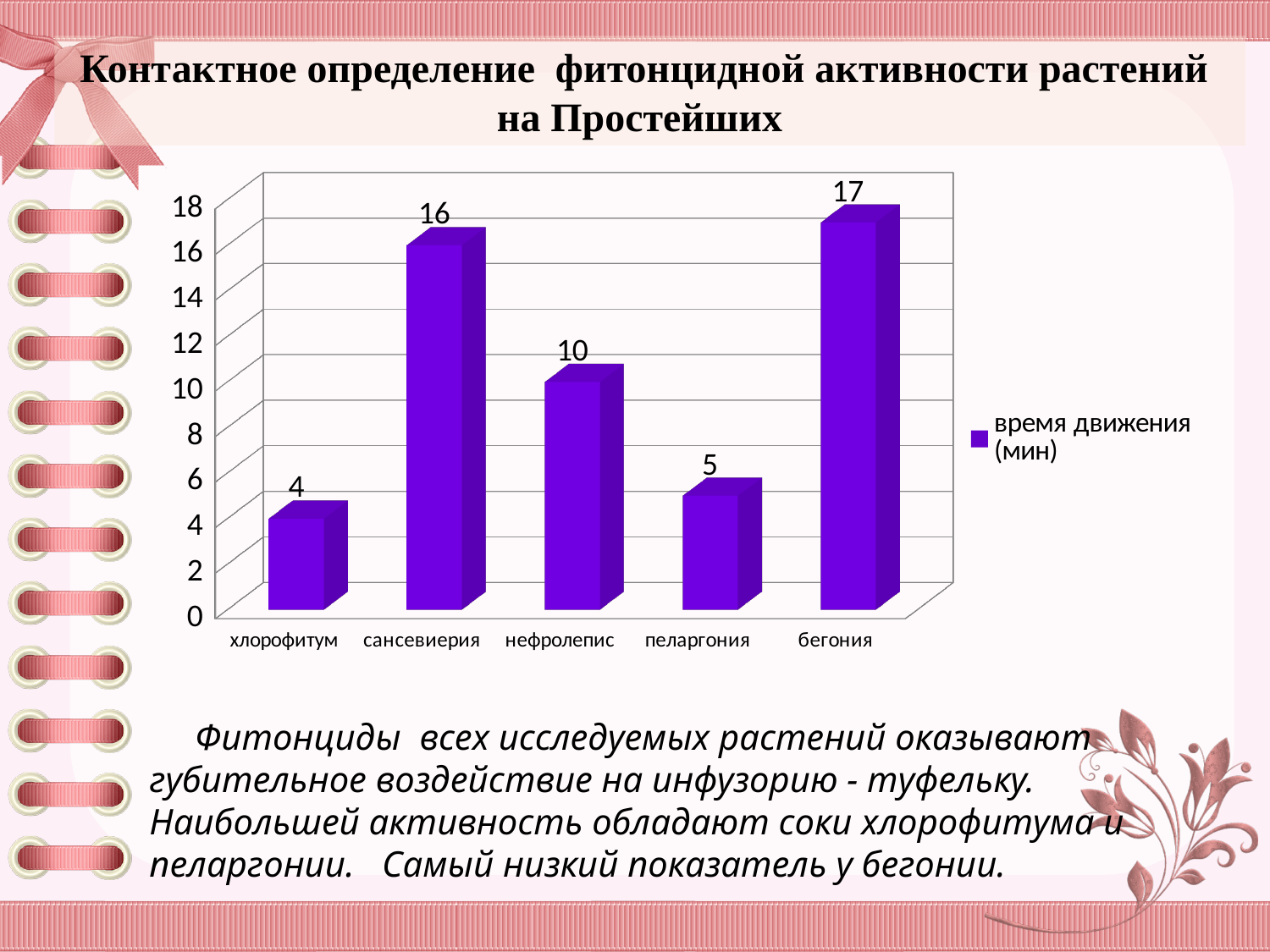
What is the value for пеларгония? 5 What kind of chart is shown on the slide? bar chart What is the difference between the values for бегония and хлорофитум? 13 Which category has the highest value? бегония Which category has the lowest value? хлорофитум Which is larger, the value for сансевиерия or the value for нефролепис? сансевиерия How many categories are shown on the x axis? 5 What is the value for хлорофитум? 4 What is the value for сансевиерия? 16 What is the value for нефролепис? 10 What is the legend entry for the series shown? время движения (мин) Is the value for бегония greater or less than 14? greater